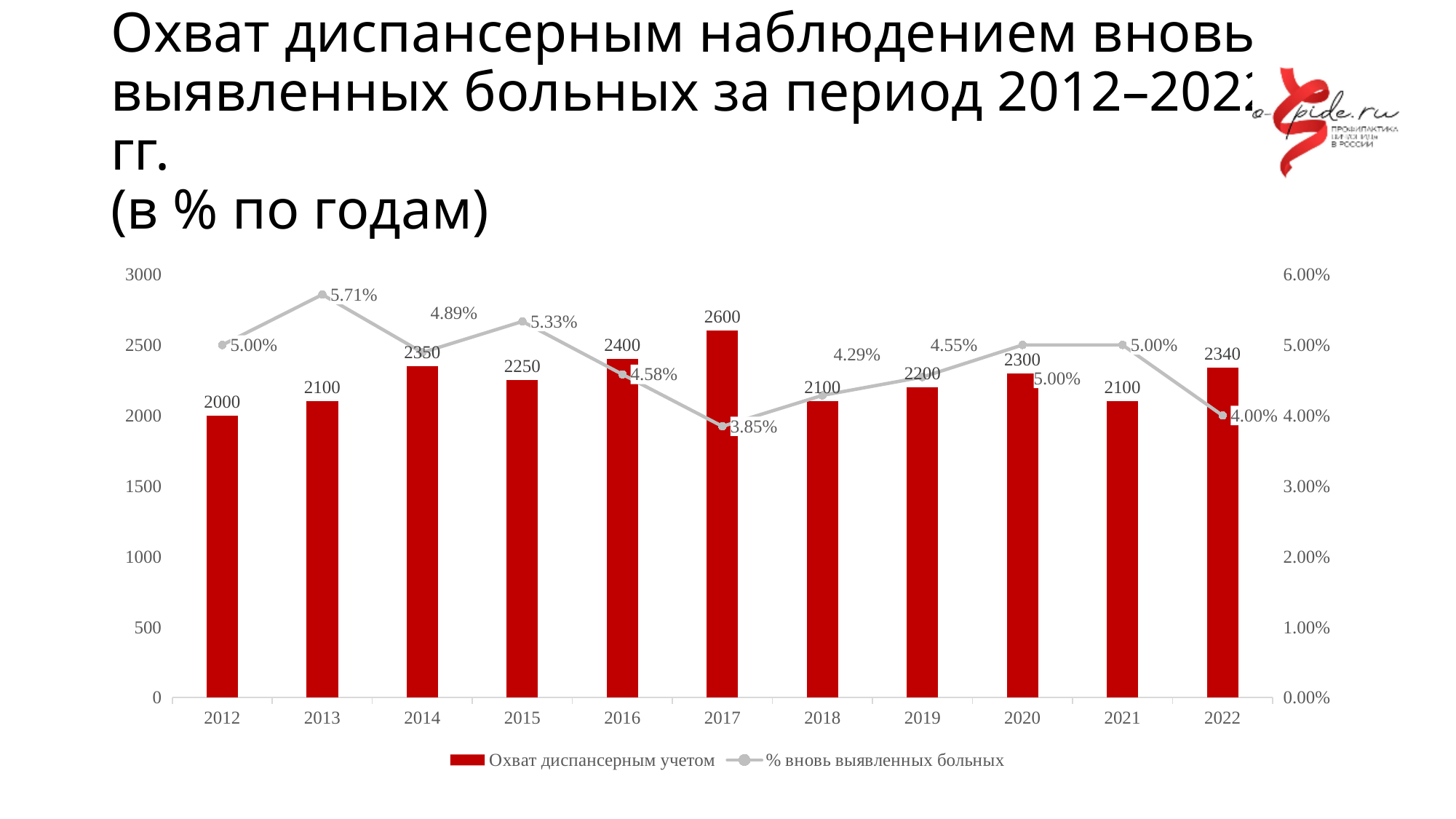
Which year has the lowest value of Охват диспансерным учетом? 2012 Which is larger, the Охват диспансерным учетом value for 2014 or for 2015? 2014 Does the % вновь выявленных больных line rise or fall from 2021 to 2022? fall What is the difference between the Охват диспансерным учетом values for 2017 and 2018? 500 Which year has the lowest value of % вновь выявленных больных? 2017 How many series does the legend list? 2 What is the value of % вновь выявленных больных for 2013? 5.71% What is the value of % вновь выявленных больных for 2017? 3.85% Which year has the highest value of Охват диспансерным учетом? 2017 What is the value of Охват диспансерным учетом for 2022? 2340 What is the value of Охват диспансерным учетом for 2017? 2600 How many years are shown on the x axis? 11